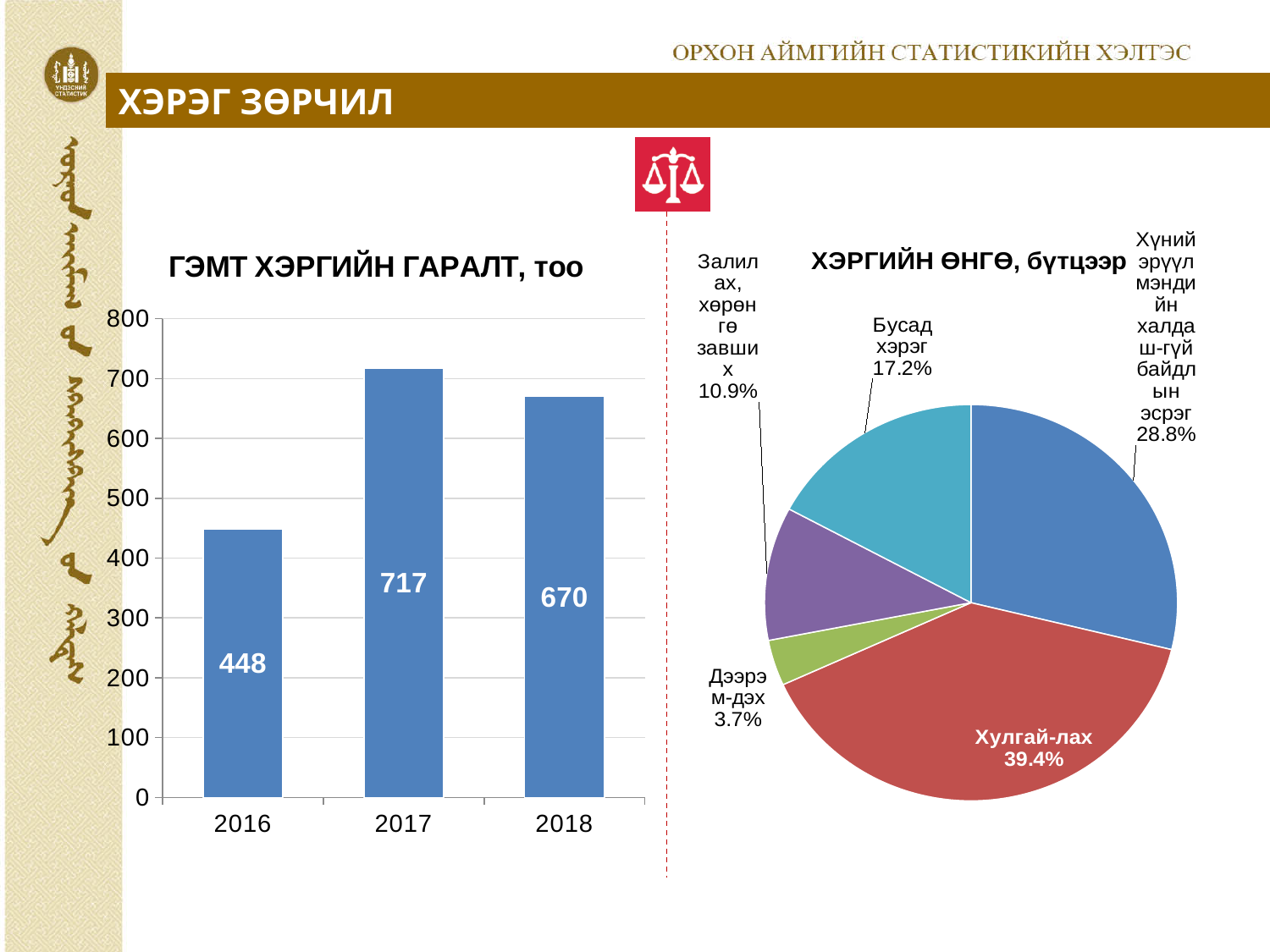
In the bar chart 'ГЭМТ ХЭРГИЙН ГАРАЛТ, тоо', what is the difference between the values for 2017 and 2018? 47 What kind of chart is 'ХЭРГИЙН ӨНГӨ, бүтцээр'? pie chart What kind of chart is 'ГЭМТ ХЭРГИЙН ГАРАЛТ, тоо'? bar chart In the pie chart 'ХЭРГИЙН ӨНГӨ, бүтцээр', how many slices are there? 5 In the bar chart 'ГЭМТ ХЭРГИЙН ГАРАЛТ, тоо', which year has the lowest value? 2016 In the bar chart 'ГЭМТ ХЭРГИЙН ГАРАЛТ, тоо', how many years are shown? 3 In the bar chart 'ГЭМТ ХЭРГИЙН ГАРАЛТ, тоо', what is the value for 2016? 448 In the bar chart 'ГЭМТ ХЭРГИЙН ГАРАЛТ, тоо', what is the value for 2017? 717 In the pie chart 'ХЭРГИЙН ӨНГӨ, бүтцээр', which category has the smallest share? Дээрэм-дэх In the pie chart 'ХЭРГИЙН ӨНГӨ, бүтцээр', what share does 'Бусад хэрэг' have? 17.2% In the bar chart 'ГЭМТ ХЭРГИЙН ГАРАЛТ, тоо', which year has the highest value? 2017 In the pie chart 'ХЭРГИЙН ӨНГӨ, бүтцээр', what share does 'Хулгай-лах' have? 39.4%